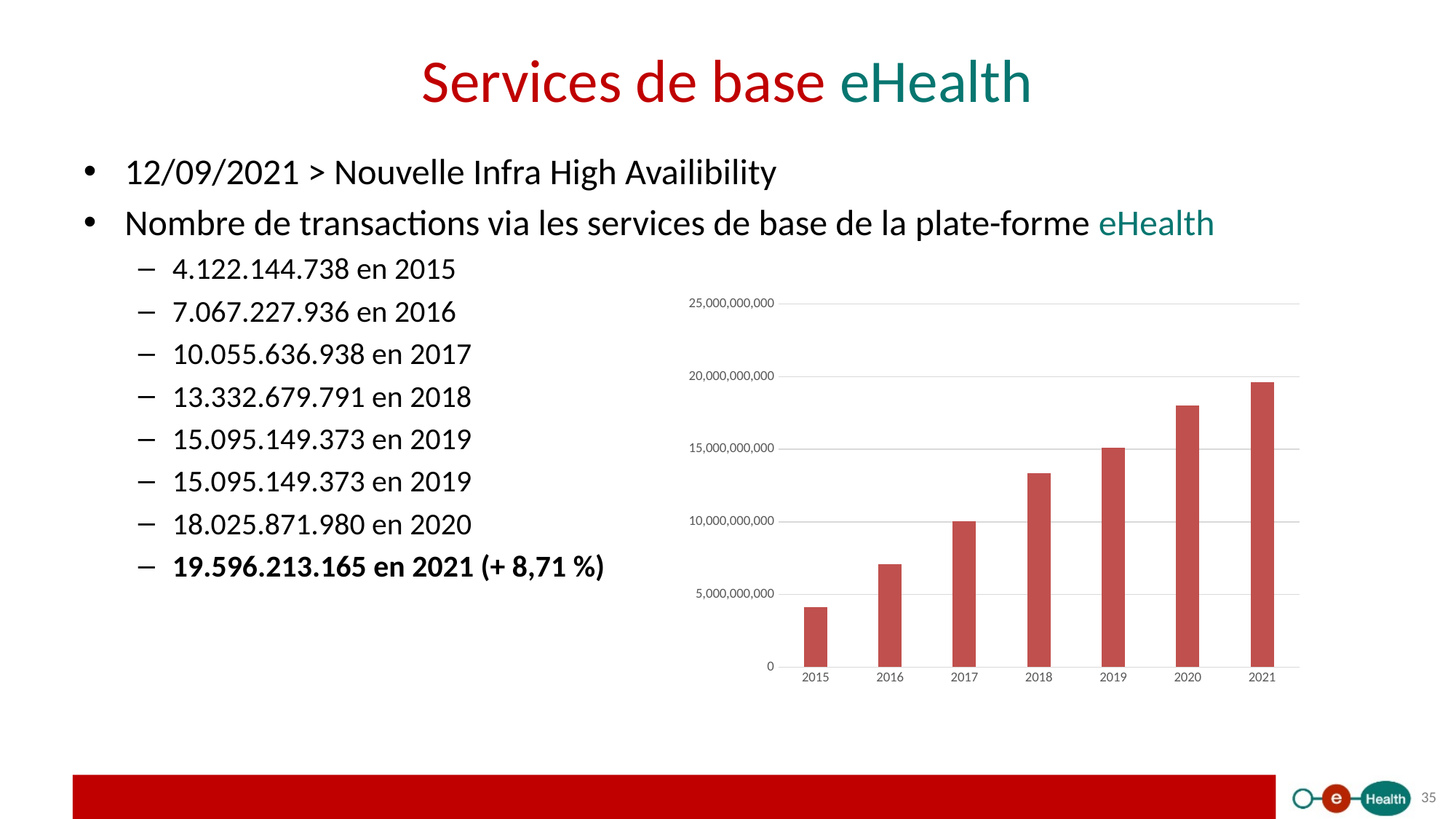
What kind of chart is shown on the slide? bar chart Is the value for 2020 greater or less than 15,000,000,000? greater Do the values in the chart rise or fall from 2015 to 2021? rise What is the highest value shown on the chart's vertical axis? 25,000,000,000 Is the value for 2016 greater or less than 10,000,000,000? less Is the value for 2021 greater or less than 20,000,000,000? less Which is larger, the value for 2018 or the value for 2019? 2019 How many years are shown on the x axis of the chart? 7 Which year has the highest bar in the chart? 2021 Which year has the lowest bar in the chart? 2015 According to the slide, what is the number of transactions in 2021? 19.596.213.165